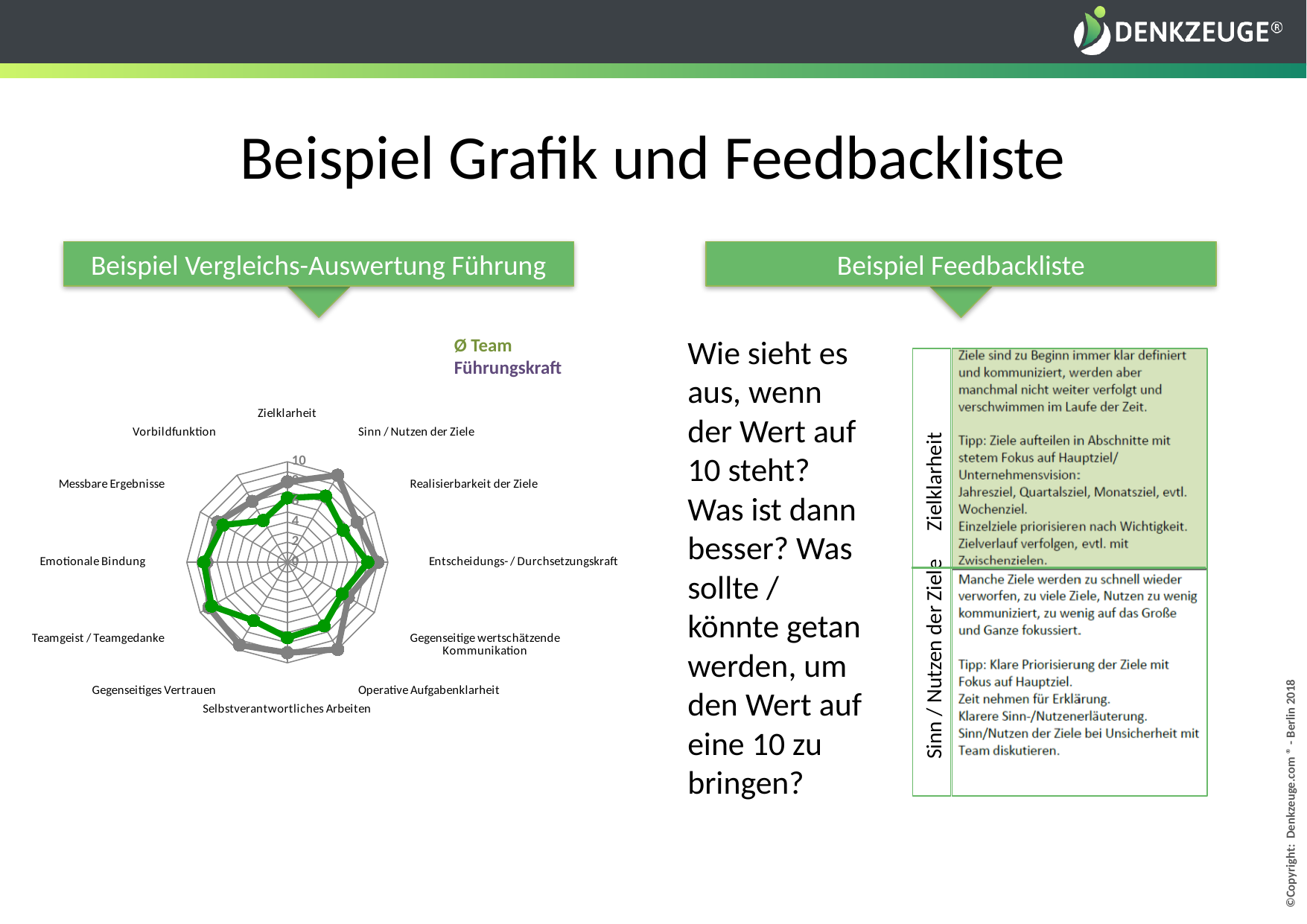
In the radar chart, which series has the higher value for Zielklarheit, Ø Team or Führungskraft? Führungskraft In the radar chart, which series has the higher value for Selbstverantwortliches Arbeiten, Ø Team or Führungskraft? Führungskraft In the radar chart, is the Ø Team value for Emotionale Bindung greater or less than 6? greater In the radar chart, is the Führungskraft value for Zielklarheit greater or less than 6? greater What is the maximum value shown on the radar chart's scale? 10 Which series in the radar chart is drawn in green? Ø Team How many series does the radar chart's legend list? 2 In the radar chart, is the Führungskraft value for Entscheidungs- / Durchsetzungskraft greater or less than 8? greater How many categories (axes) does the radar chart have? 12 What kind of chart is shown under "Beispiel Vergleichs-Auswertung Führung"? Radar chart In the radar chart, which series has the higher value for Messbare Ergebnisse, Ø Team or Führungskraft? Führungskraft